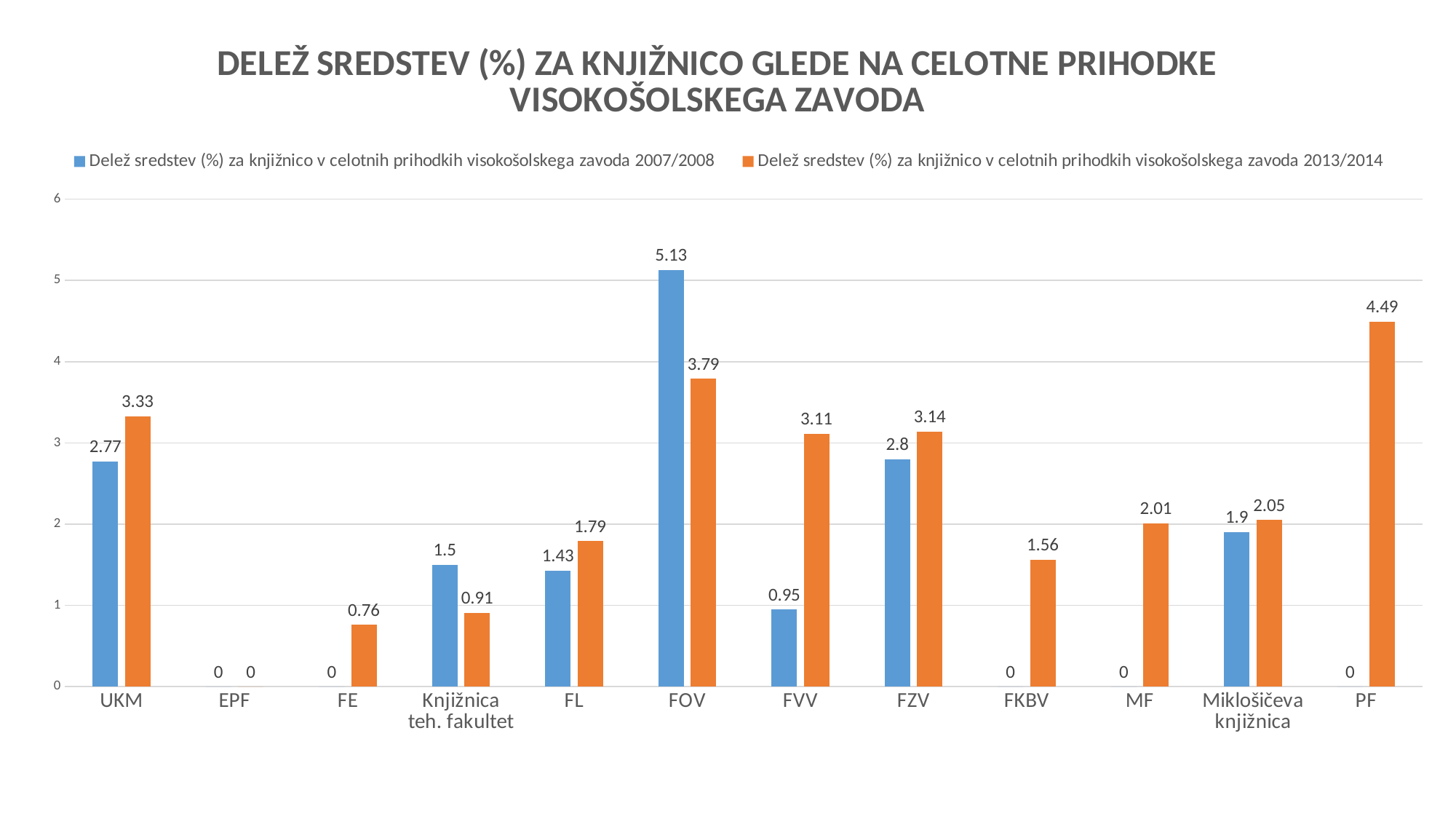
What kind of chart is shown on the slide? Bar chart Which category has the highest value in the 2007/2008 series? FOV Which is larger for Knjižnica teh. fakultet: the 2007/2008 value or the 2013/2014 value? 2007/2008 What is the difference between the 2013/2014 and 2007/2008 values for FVV? 2.16 Is the 2013/2014 value for FZV greater or less than 3? greater How many categories are shown on the x axis? 12 Which category has the highest value in the 2013/2014 series? PF What is the value for UKM in the 2013/2014 series? 3.33 What is the difference between the 2007/2008 and 2013/2014 values for FOV? 1.34 How many series does the legend list? 2 What is the value for FOV in the 2007/2008 series? 5.13 What is the value for PF in the 2013/2014 series? 4.49